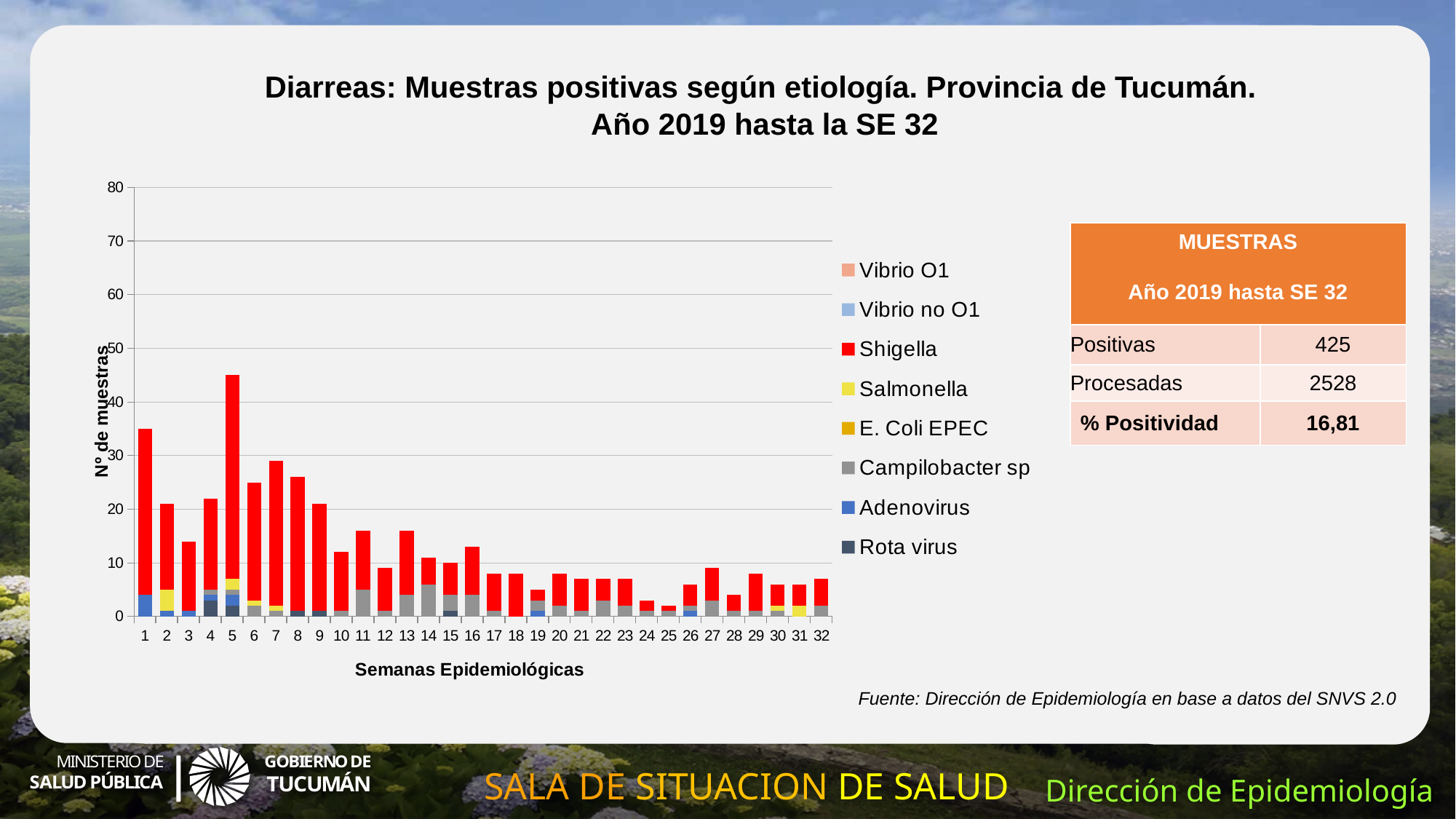
Is the total value for week 25 greater or less than 10? less What kind of chart is shown on the slide? Stacked bar chart What is the label of the x axis? Semanas Epidemiológicas Which week has a taller bar, week 5 or week 9? Week 5 Which week has a taller bar, week 1 or week 2? Week 1 Which epidemiological week has the highest total number of positive samples? 5 Which etiology is shown in red in the legend? Shigella How many series does the legend list? 8 Overall, do the bar totals rise or fall from week 1 to week 32? Fall Is the total value for week 5 greater or less than 40? greater How many epidemiological weeks are plotted on the x axis? 32 Is the total value for week 1 greater or less than 30? greater